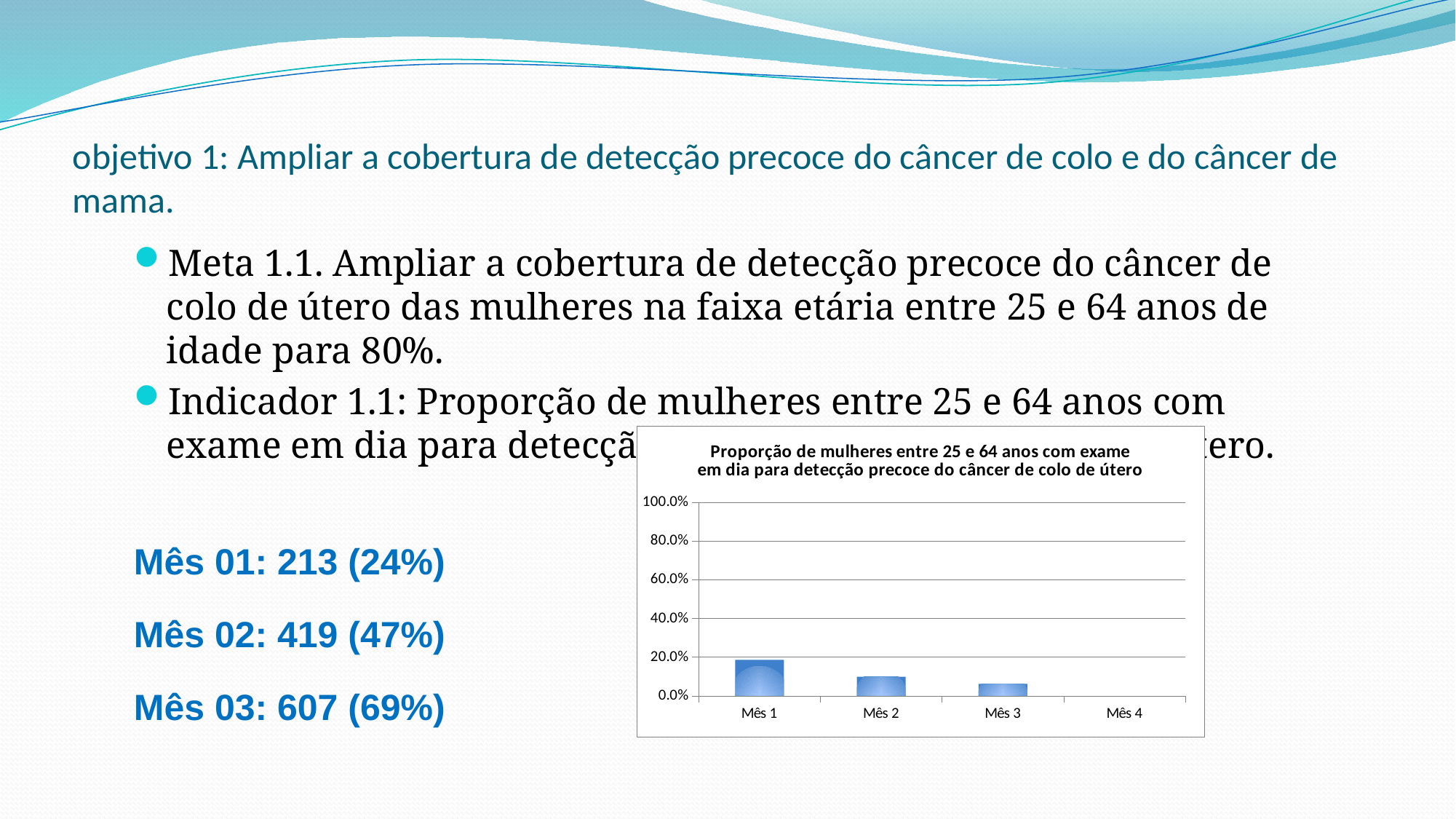
Among Mês 1, Mês 2 and Mês 3, which has the shortest bar in the chart? Mês 3 What kind of chart is shown on the slide? bar chart Which month has the tallest bar in the chart? Mês 1 Is the bar for Mês 1 greater or less than 40.0%? less Which is larger in the chart, the bar for Mês 2 or the bar for Mês 3? Mês 2 Which is larger in the chart, the bar for Mês 1 or the bar for Mês 2? Mês 1 Is the bar for Mês 3 greater or less than 20.0%? less Do the bar values rise or fall from Mês 1 to Mês 3? fall How many categories are shown on the x axis of the chart? 4 Is the bar for Mês 2 greater or less than 20.0%? less What is the highest value shown on the chart's y axis? 100.0%